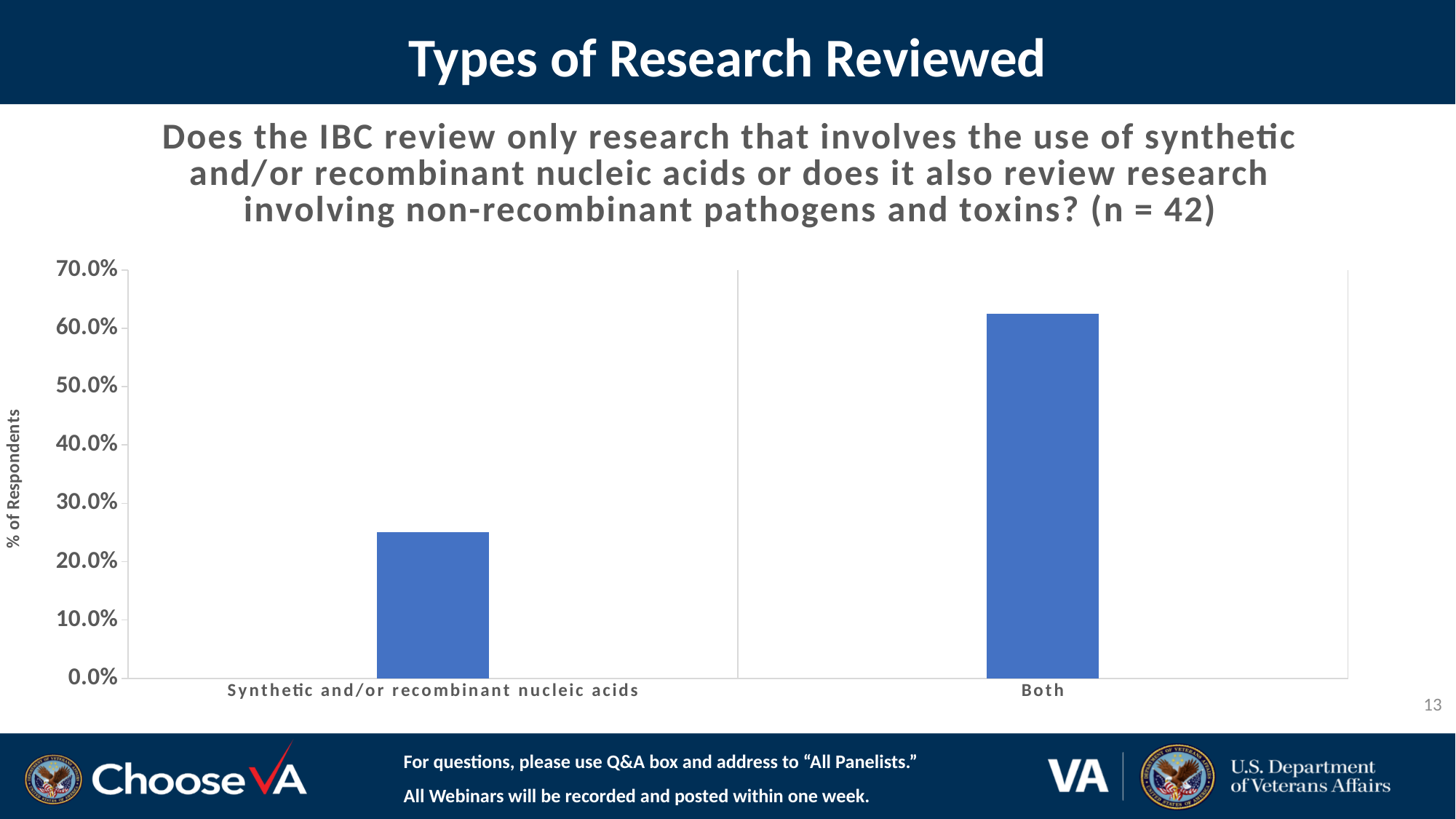
What is the sample size (n) stated in the chart title? 42 Which is larger: the value for Both or the value for Synthetic and/or recombinant nucleic acids? Both What kind of chart is shown on the slide? bar chart Is the value for Both greater or less than 70.0%? less Is the value for Synthetic and/or recombinant nucleic acids greater or less than 30.0%? less Which category has the lowest value? Synthetic and/or recombinant nucleic acids How many categories are plotted in the chart? 2 Is the value for Synthetic and/or recombinant nucleic acids greater or less than 20.0%? greater Which category has the highest value? Both What is the label of the vertical axis? % of Respondents